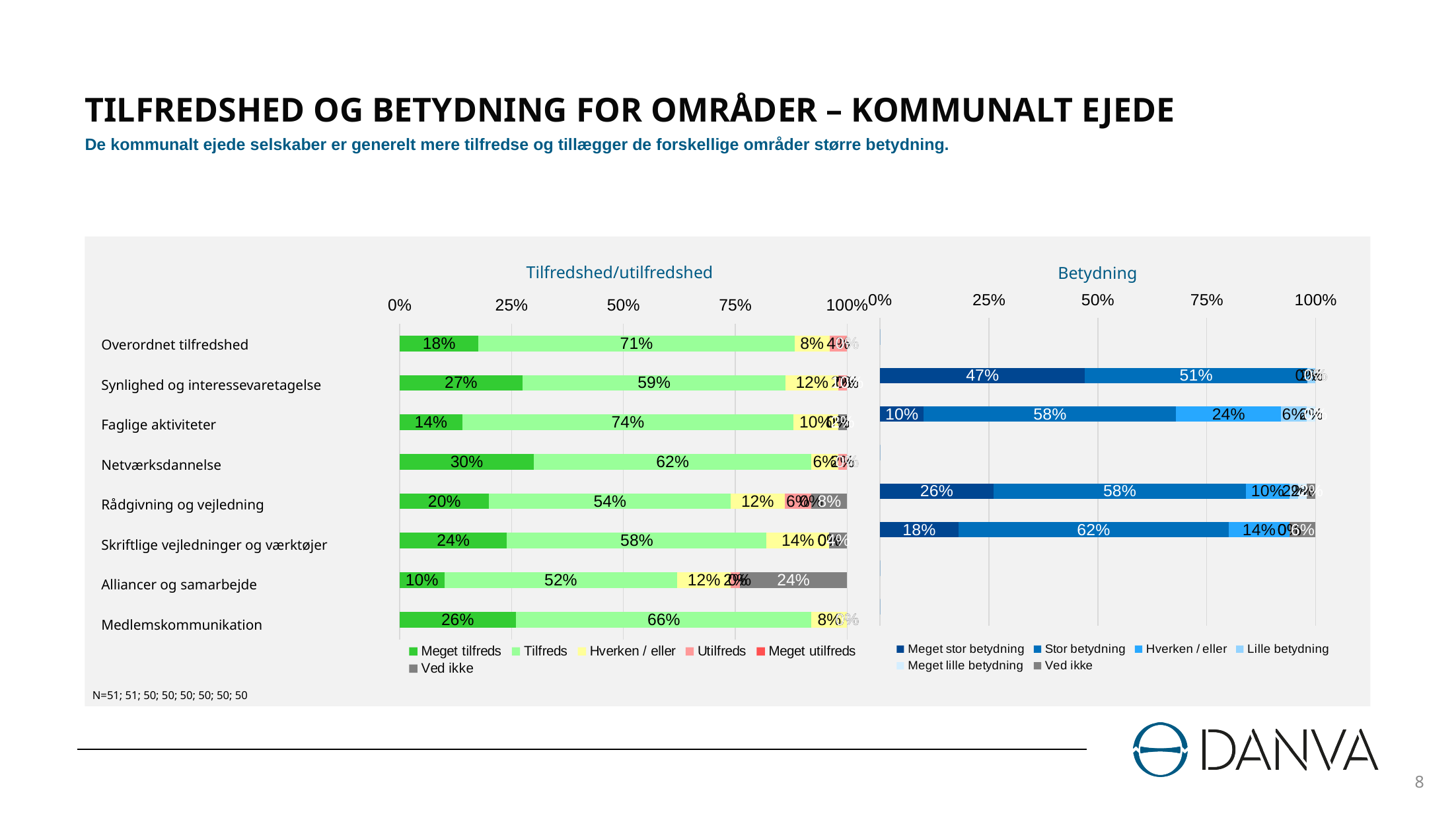
What kind of chart is the 'Tilfredshed/utilfredshed' chart? Stacked bar chart In the 'Betydning' chart, what is the 'Stor betydning' value for Skriftlige vejledninger og værktøjer? 62% In the 'Betydning' chart, what is the 'Meget stor betydning' value for Synlighed og interessevaretagelse? 47% In the 'Tilfredshed/utilfredshed' chart, what is the difference between the 'Tilfreds' values for Faglige aktiviteter and Alliancer og samarbejde? 22 percentage points How many categories are shown in the 'Tilfredshed/utilfredshed' chart? 8 In the 'Tilfredshed/utilfredshed' chart, which has the larger 'Tilfreds' value: Overordnet tilfredshed or Rådgivning og vejledning? Overordnet tilfredshed In the 'Tilfredshed/utilfredshed' chart, what is the 'Tilfreds' value for Faglige aktiviteter? 74% In the 'Tilfredshed/utilfredshed' chart, which category has the highest 'Meget tilfreds' value? Netværksdannelse In the 'Betydning' chart, what is the 'Hverken / eller' value for Faglige aktiviteter? 24% In the 'Tilfredshed/utilfredshed' chart, what is the 'Ved ikke' value for Alliancer og samarbejde? 24% In the 'Tilfredshed/utilfredshed' chart, which category has the lowest 'Meget tilfreds' value? Alliancer og samarbejde How many series does the legend of the 'Tilfredshed/utilfredshed' chart list? 6